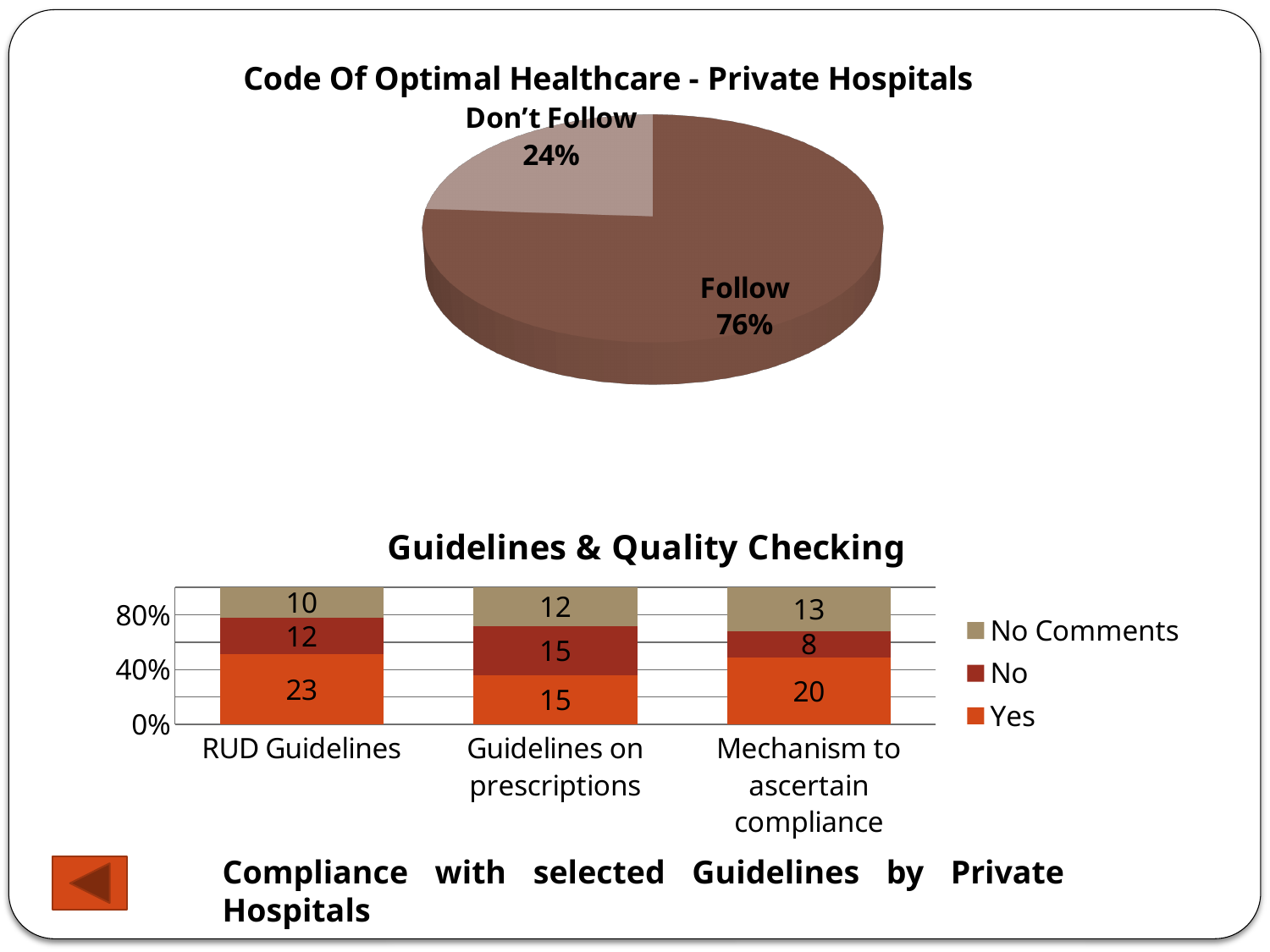
In the 'Guidelines & Quality Checking' chart, what is the total of the stacked bar for RUD Guidelines? 45 In the 'Code Of Optimal Healthcare - Private Hospitals' chart, which slice is larger, 'Follow' or 'Don't Follow'? Follow What kind of chart is 'Code Of Optimal Healthcare - Private Hospitals'? Pie chart In the 'Guidelines & Quality Checking' chart, what is the 'No Comments' value for Guidelines on prescriptions? 12 In the 'Code Of Optimal Healthcare - Private Hospitals' pie chart, what percentage of hospitals follow the code? 76% In the 'Code Of Optimal Healthcare - Private Hospitals' pie chart, what share is labelled 'Don't Follow'? 24% In the 'Guidelines & Quality Checking' chart, how many series does the legend list? 3 In the 'Guidelines & Quality Checking' chart, which category has the highest 'Yes' value? RUD Guidelines In the 'Guidelines & Quality Checking' chart, what is the 'Yes' value for RUD Guidelines? 23 In the 'Guidelines & Quality Checking' chart, which category has the lowest 'No' value? Mechanism to ascertain compliance In the 'Guidelines & Quality Checking' chart, what is the difference between the 'Yes' values for RUD Guidelines and Guidelines on prescriptions? 8 In the 'Guidelines & Quality Checking' chart, what is the 'No' value for Mechanism to ascertain compliance? 8